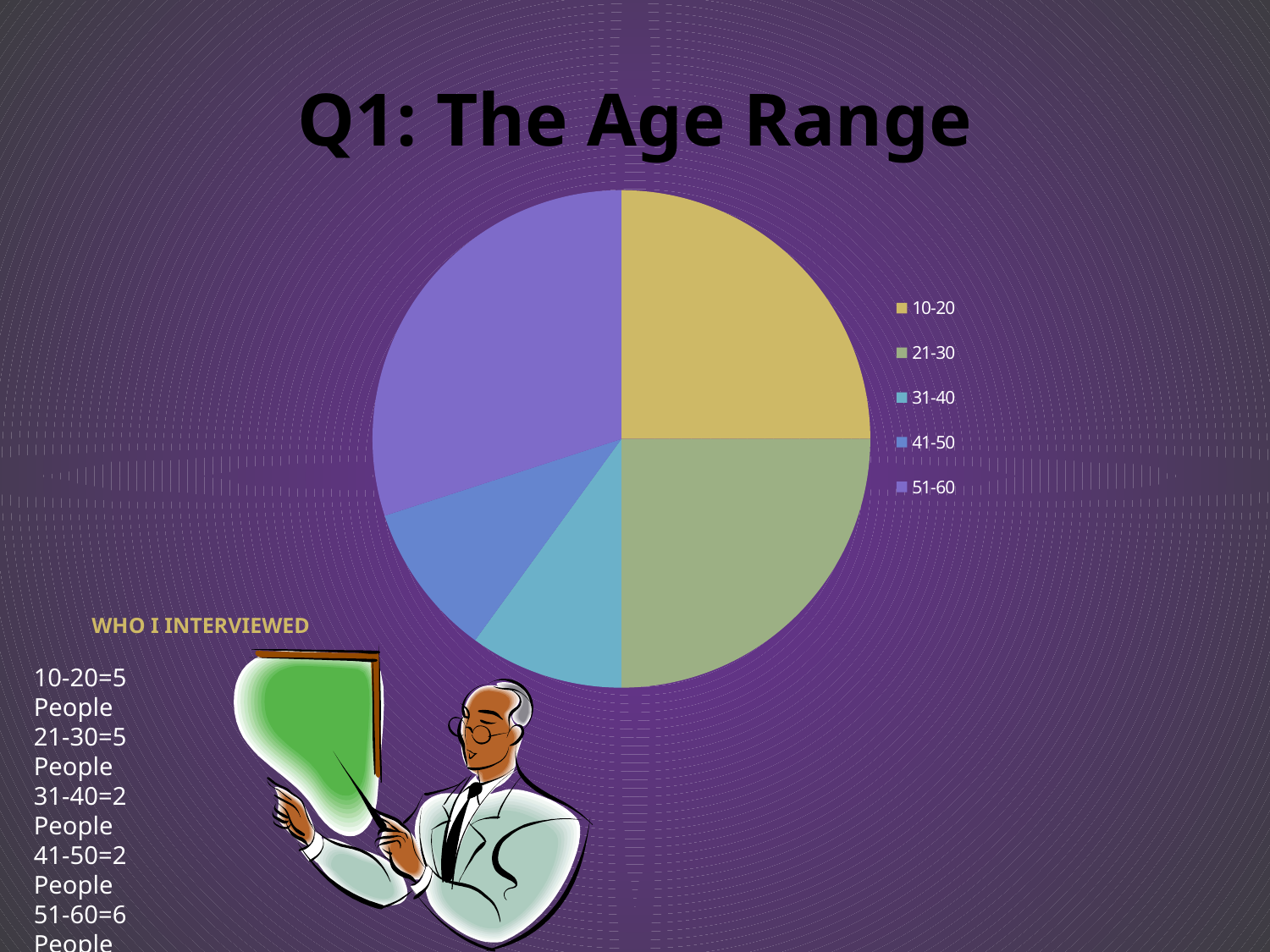
According to the slide, how many people were interviewed in the 10-20 age range? 5 Which slice is larger, 10-20 or 31-40? 10-20 According to the slide, how many people were interviewed in the 31-40 age range? 2 Which age range has the largest slice of the pie chart? 51-60 What share of the pie does the 51-60 slice represent? 30% Which slice is larger, 51-60 or 21-30? 51-60 According to the slide, how many people were interviewed in the 51-60 age range? 6 What is the difference between the number of people in the 51-60 range and the 41-50 range? 4 What type of chart is shown on the slide? pie chart How many entries does the legend of the pie chart list? 5 How many age-range categories does the pie chart have? 5 What is the title of the chart slide? Q1: The Age Range